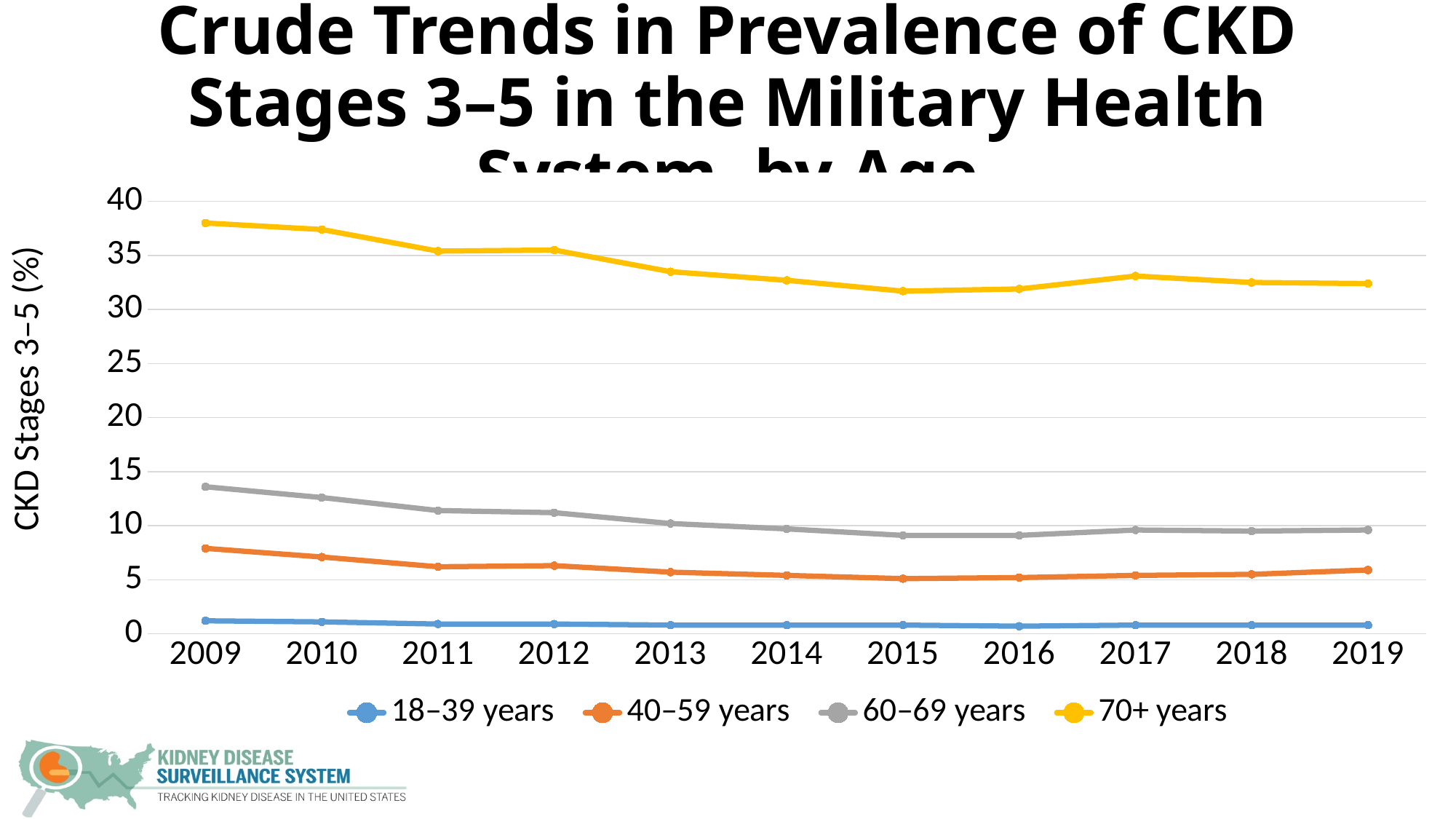
Is the value for 40–59 years in 2015 greater or less than 10? less What type of chart is shown on the slide? line chart Which age group has the lowest CKD Stages 3–5 prevalence in 2019? 18–39 years Is the value for 70+ years in 2009 greater or less than 35? greater In 2019, which is larger: the value for 60–69 years or the value for 40–59 years? 60–69 years Is the value for 70+ years in 2015 greater or less than 35? less How many years are plotted along the x axis? 11 Which age group has the highest CKD Stages 3–5 prevalence in 2009? 70+ years What is the label on the y axis? CKD Stages 3–5 (%) Does the prevalence for 70+ years rise or fall from 2009 to 2015? fall How many series does the legend list? 4